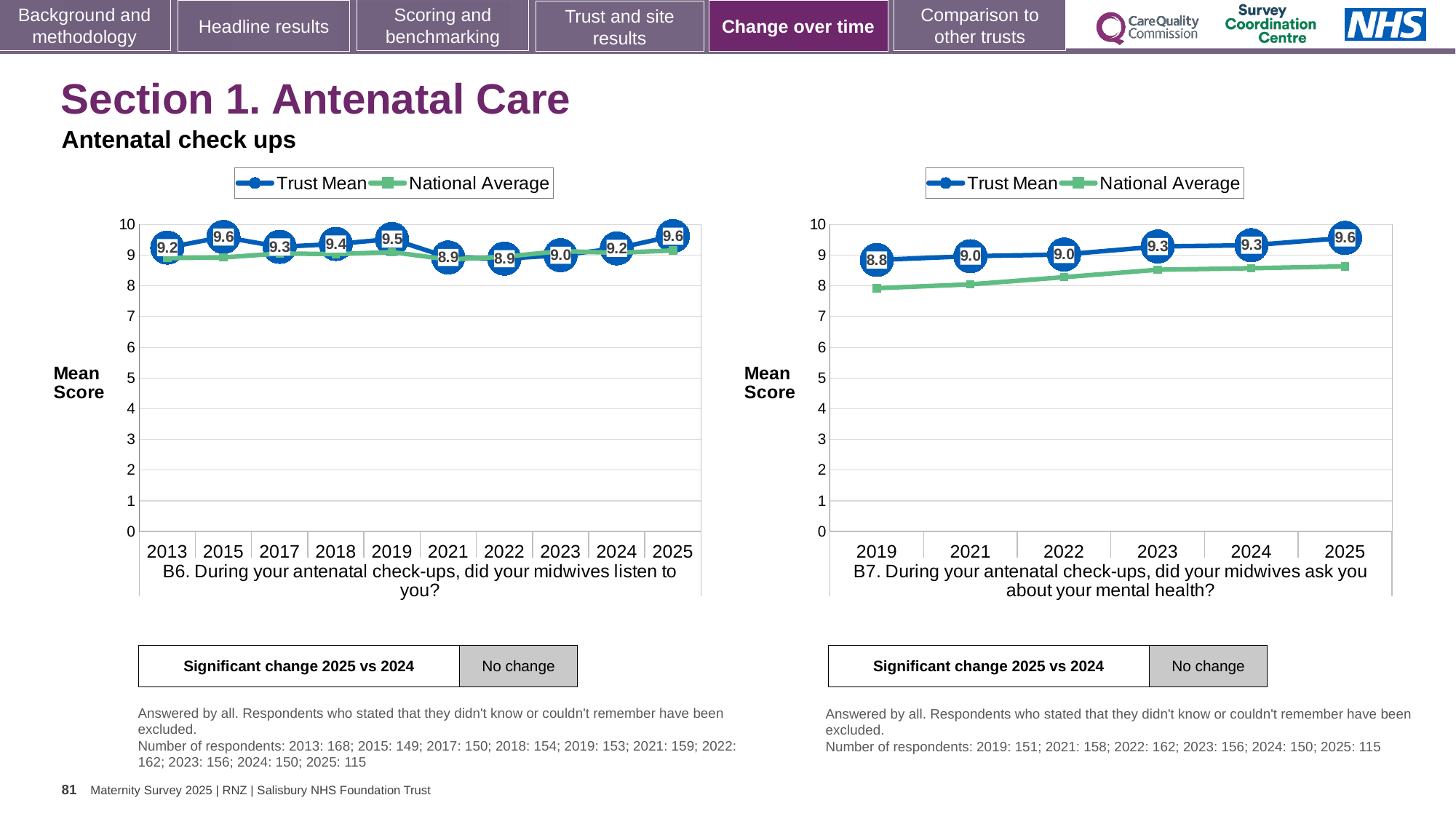
In the B7 chart (right), what was the Trust Mean in 2025? 9.6 In the B6 chart (left), what was the Trust Mean in 2013? 9.2 How many years are plotted on the x axis of the B7 chart (right)? 6 In the B7 chart (right), what is the difference between the Trust Mean in 2025 and in 2019? 0.8 In the B6 chart (left), what is the difference between the Trust Mean in 2025 and in 2024? 0.4 In the B7 chart (right), which year has the highest Trust Mean? 2025 In the B7 chart (right), does the Trust Mean rise or fall from 2019 to 2025? rise In the B6 chart (left), which is larger: the Trust Mean in 2015 or in 2022? 2015 In the B6 chart (left), what was the Trust Mean in 2021? 8.9 In the B7 chart (right), which year has the lowest Trust Mean? 2019 How many series does the legend of the B6 chart (left) list? 2